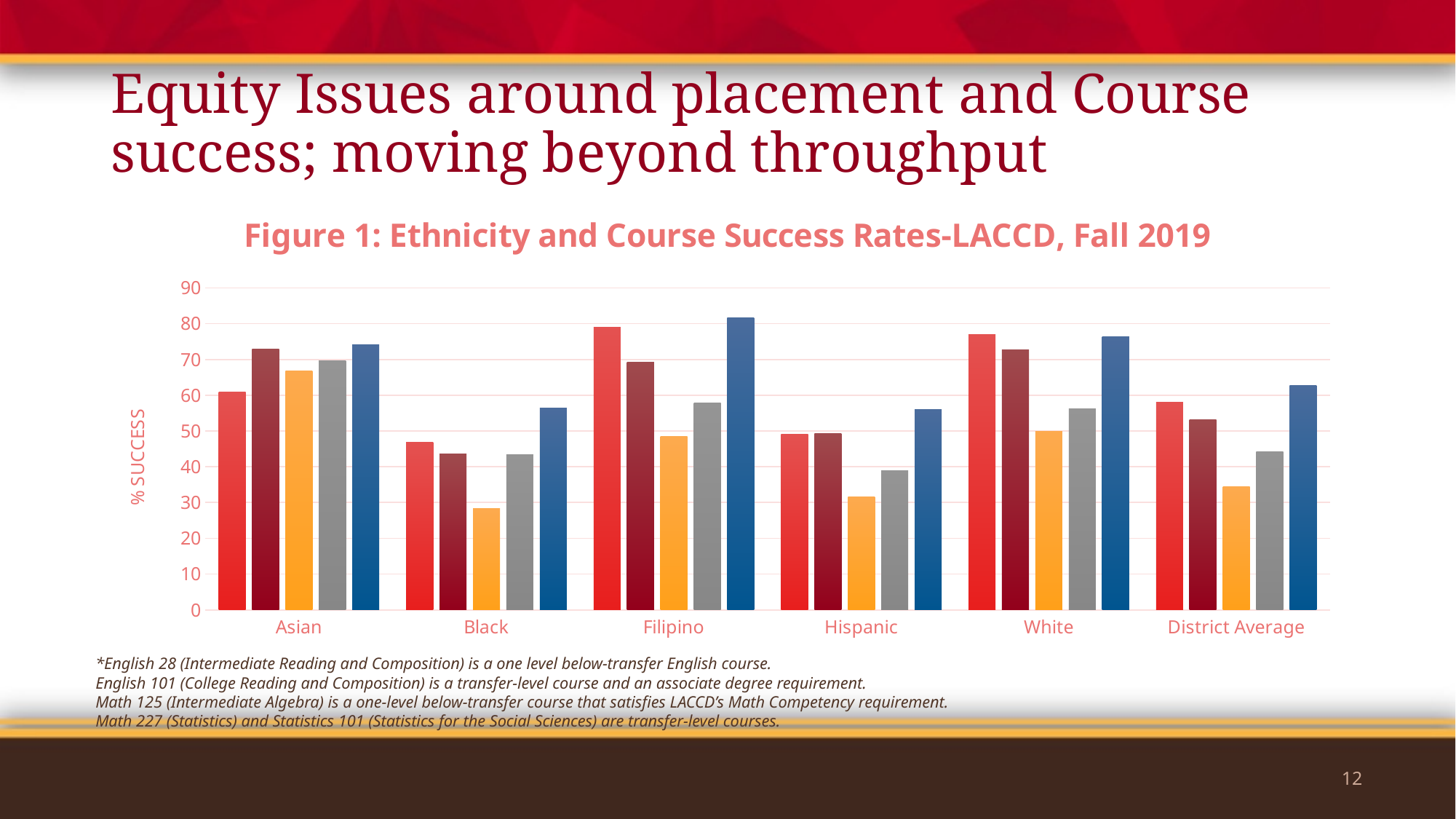
What is the label on the vertical axis of the chart? % SUCCESS Which category has the highest blue bar? Filipino How many ethnicity categories are shown along the x axis? 6 Is the value of the blue bar for Filipino greater or less than 70? greater What kind of chart is shown on the slide? bar chart How many bars are plotted for each category? 5 Is the value of the orange bar for Black greater or less than 40? less Is the value of the grey bar for Hispanic greater or less than 50? less What is the title of the chart? Figure 1: Ethnicity and Course Success Rates-LACCD, Fall 2019 Is the blue bar for Asian larger or smaller than the blue bar for Black? larger Which category has the lowest grey bar? Hispanic